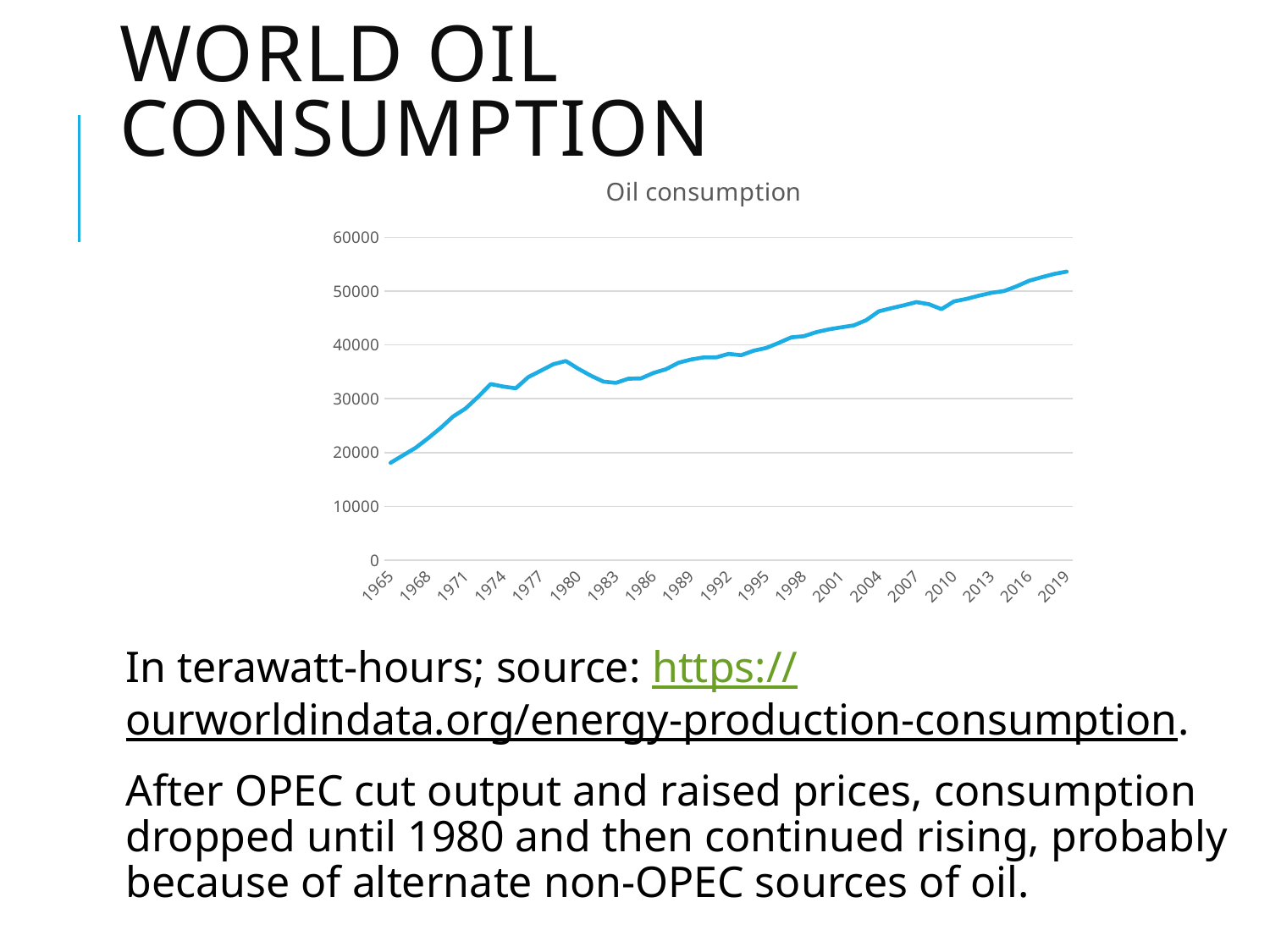
How many year labels are shown on the x axis? 19 Which is larger, the value for 1980 or the value for 1983? 1980 Is the value for 2019 greater or less than 50000? greater Is the value for 1965 greater or less than 20000? less What kind of chart is shown on the slide? line chart Is the value for 1980 greater or less than 40000? less Which is larger, the value for 1974 or the value for 1977? 1977 Which year has the highest oil consumption value on the chart? 2019 What is the title of the chart? Oil consumption Overall, do the values rise or fall from 1965 to 2019? rise Which year has the lowest oil consumption value on the chart? 1965